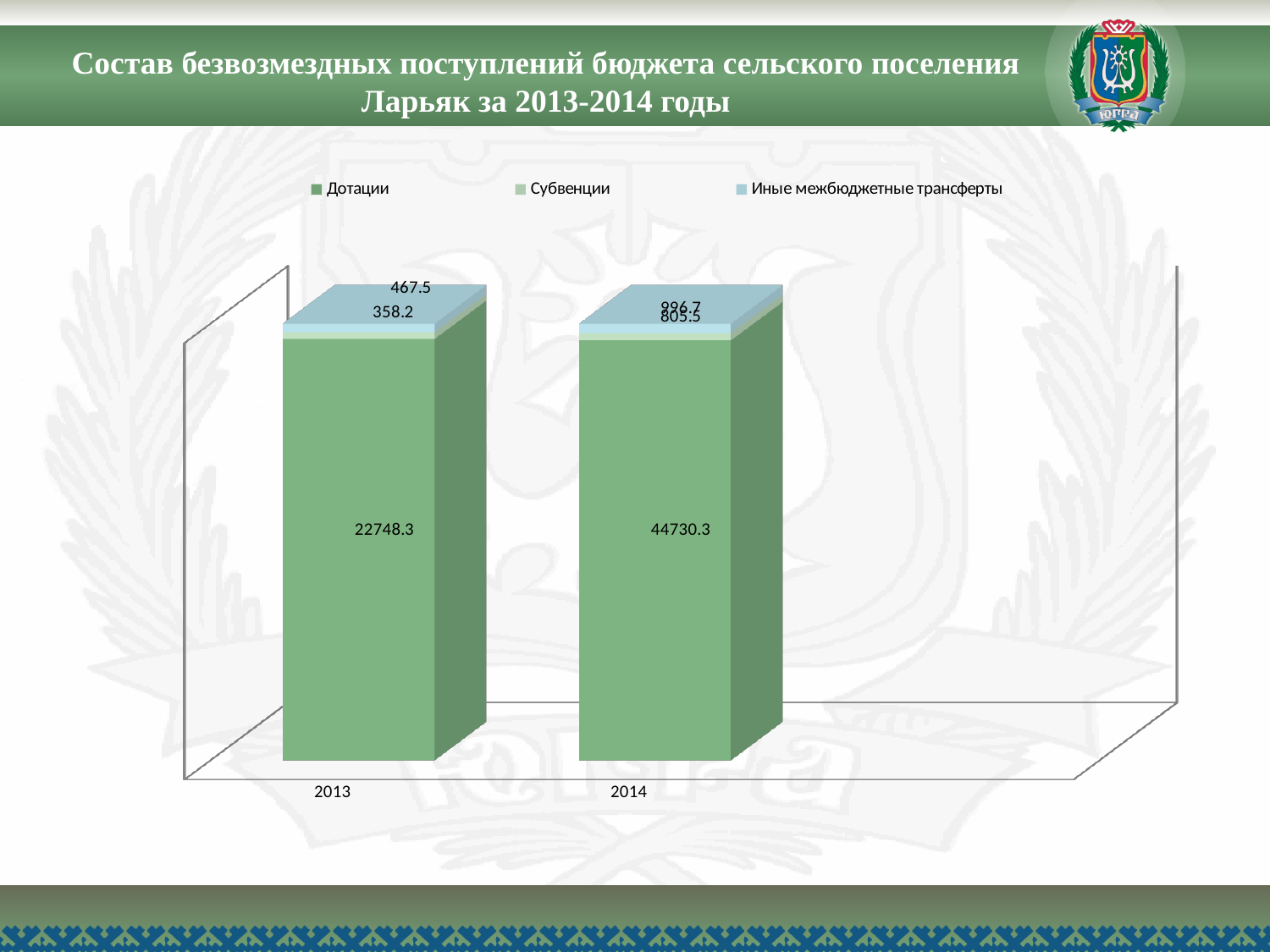
How many years (categories) are shown on the x axis? 2 Which year has the higher value for Дотации, 2013 or 2014? 2014 How many series does the legend list? 3 What is the value of Иные межбюджетные трансферты for 2013? 467.5 What is the value of Субвенции for 2013? 358.2 What is the value of Субвенции for 2014? 805.5 What is the value of Дотации for 2013? 22748.3 What type of chart is shown on the slide? Stacked bar chart What is the difference between the Дотации values for 2014 and 2013? 21982.0 Which series is shown in the darkest green colour in the legend? Дотации What is the value of Дотации for 2014? 44730.3 What is the total of the stacked bar for 2013? 23574.0